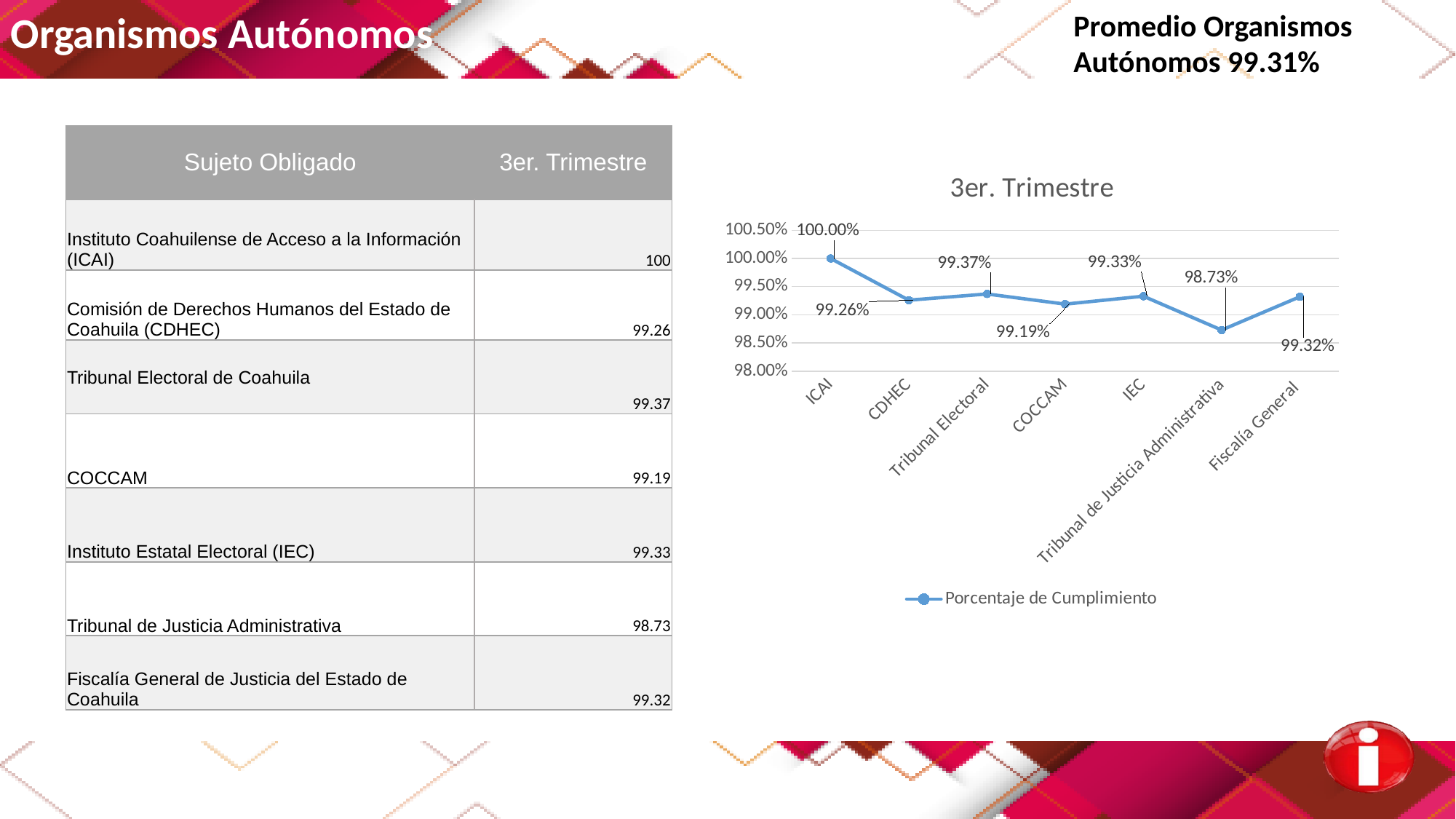
What is the value for Fiscalía General in the chart? 99.32% Which category has the highest value in the chart? ICAI Which category has the lowest value in the chart? Tribunal de Justicia Administrativa What is the value for COCCAM in the chart? 99.19% What is the value for ICAI in the chart? 100.00% What is the difference between the values for ICAI and Tribunal de Justicia Administrativa? 1.27% What type of chart is shown on the slide? line chart How many categories are plotted on the x axis of the chart? 7 What series name does the chart legend show? Porcentaje de Cumplimiento What is the value for Tribunal de Justicia Administrativa in the chart? 98.73% What is the title of the chart? 3er. Trimestre Which has a larger value, Tribunal Electoral or COCCAM? Tribunal Electoral